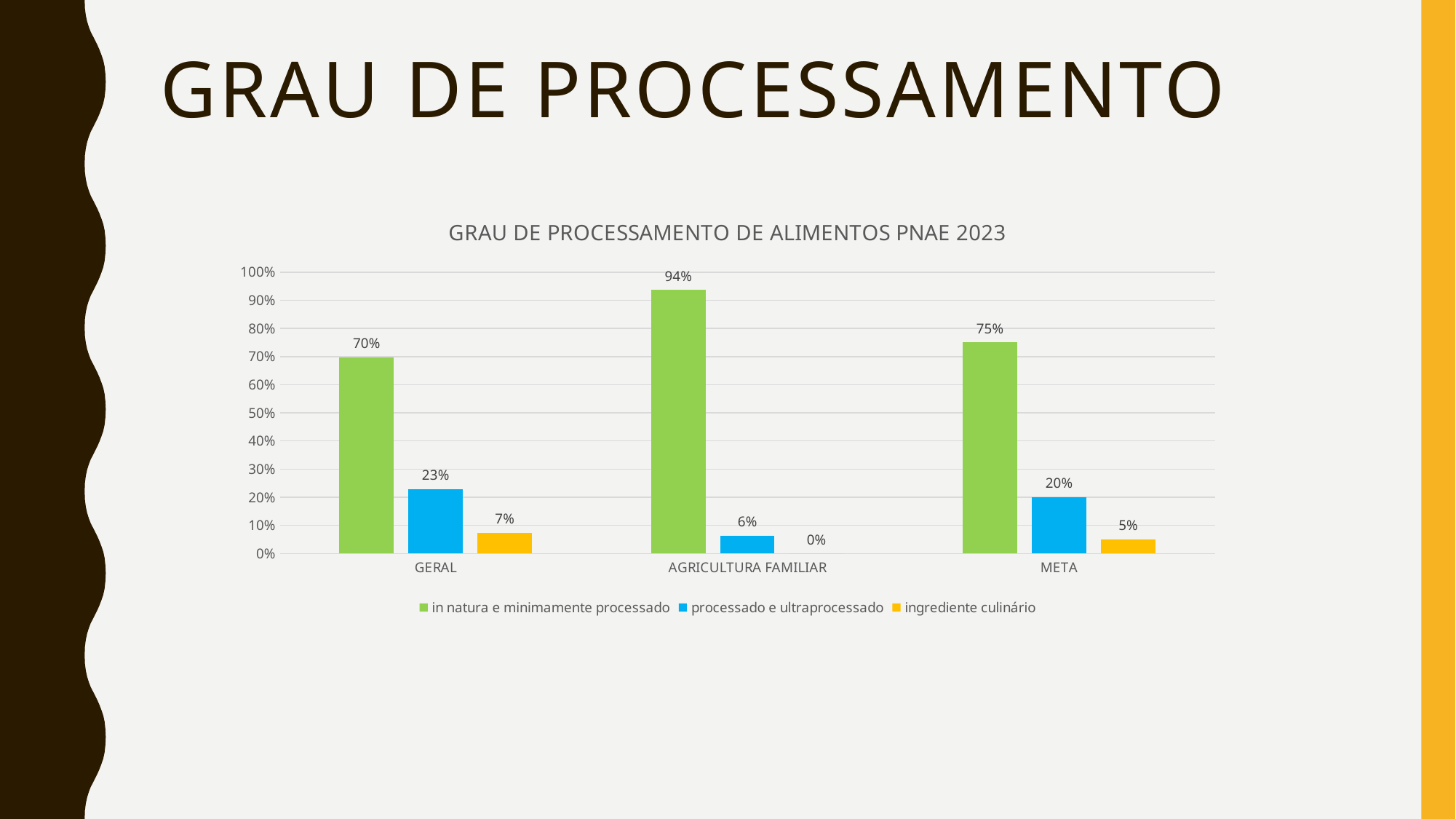
How many categories are shown on the x axis? 3 What is the title of the chart? GRAU DE PROCESSAMENTO DE ALIMENTOS PNAE 2023 What is the value for 'processado e ultraprocessado' in the AGRICULTURA FAMILIAR category? 6% Which is larger: 'processado e ultraprocessado' for GERAL or for META? GERAL Which category has the lowest value for 'ingrediente culinário'? AGRICULTURA FAMILIAR What is the value for 'in natura e minimamente processado' in the GERAL category? 70% How many series does the legend list? 3 What is the difference between the 'in natura e minimamente processado' values for AGRICULTURA FAMILIAR and GERAL? 24% What is the value for 'ingrediente culinário' in the META category? 5% Is the value for 'in natura e minimamente processado' in META greater or less than 70%? greater What kind of chart is shown on the slide? Bar chart Which category has the highest value for 'in natura e minimamente processado'? AGRICULTURA FAMILIAR